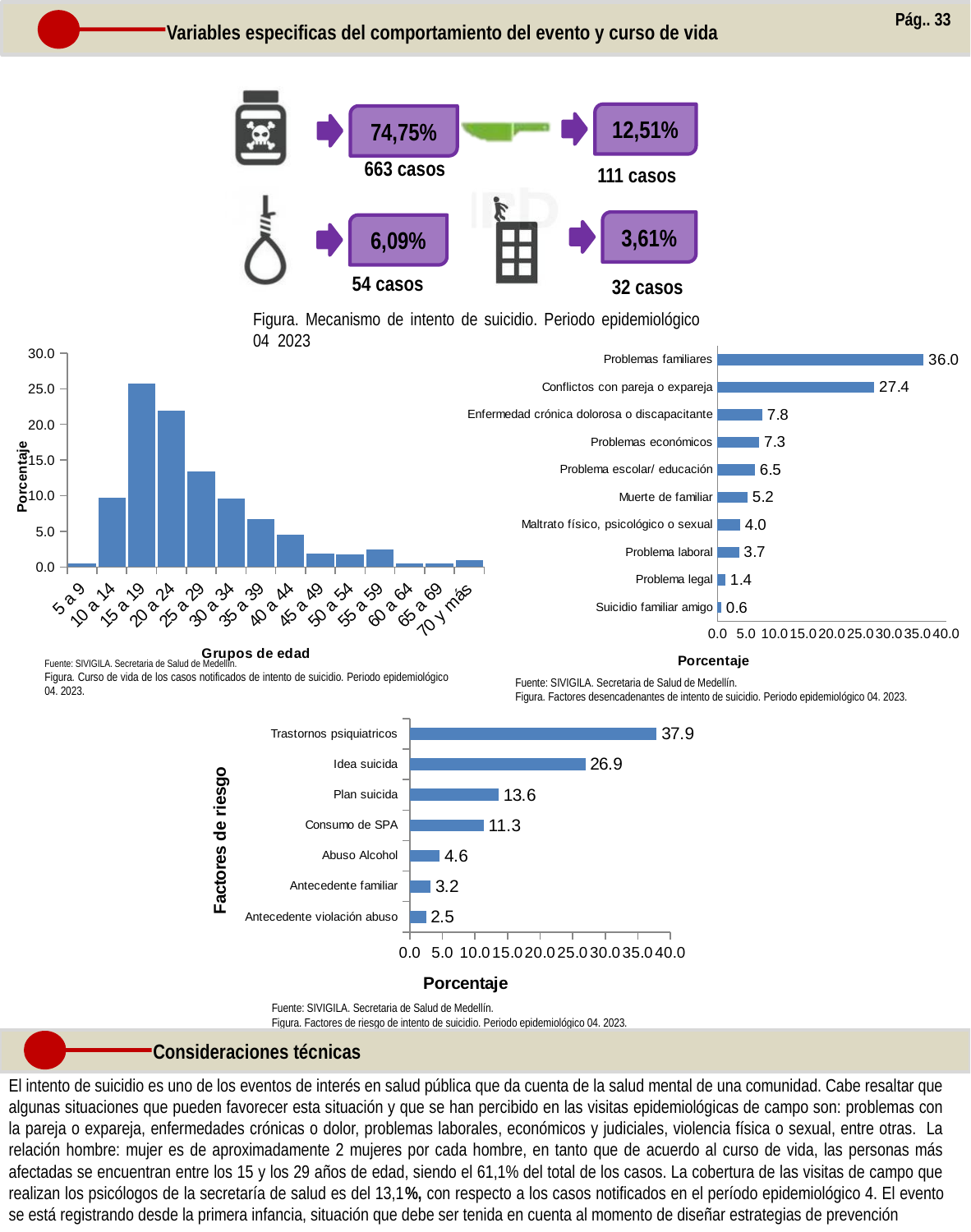
What type of chart is the 'Curso de vida' chart by Grupos de edad? Bar chart In the 'Factores de riesgo de intento de suicidio' chart, how many categories are shown? 7 In the 'Curso de vida' chart by Grupos de edad, is the value for 20 a 24 greater or less than 20.0? greater In the 'Factores de riesgo de intento de suicidio' chart, which is larger: Plan suicida or Abuso Alcohol? Plan suicida In the 'Factores desencadenantes de intento de suicidio' chart, what is the value for Problemas familiares? 36.0 In the 'Factores de riesgo de intento de suicidio' chart, what is the difference between Idea suicida and Plan suicida? 13.3 In the 'Factores desencadenantes de intento de suicidio' chart, which category has the lowest value? Suicidio familiar amigo In the 'Factores desencadenantes de intento de suicidio' chart, how many categories are shown? 10 In the 'Factores de riesgo de intento de suicidio' chart, which category has the highest value? Trastornos psiquiatricos In the 'Factores de riesgo de intento de suicidio' chart, what is the value for Consumo de SPA? 11.3 In the 'Curso de vida' chart by Grupos de edad, which age group has the highest percentage? 15 a 19 In the 'Factores desencadenantes de intento de suicidio' chart, what is the difference between Problemas familiares and Conflictos con pareja o expareja? 8.6